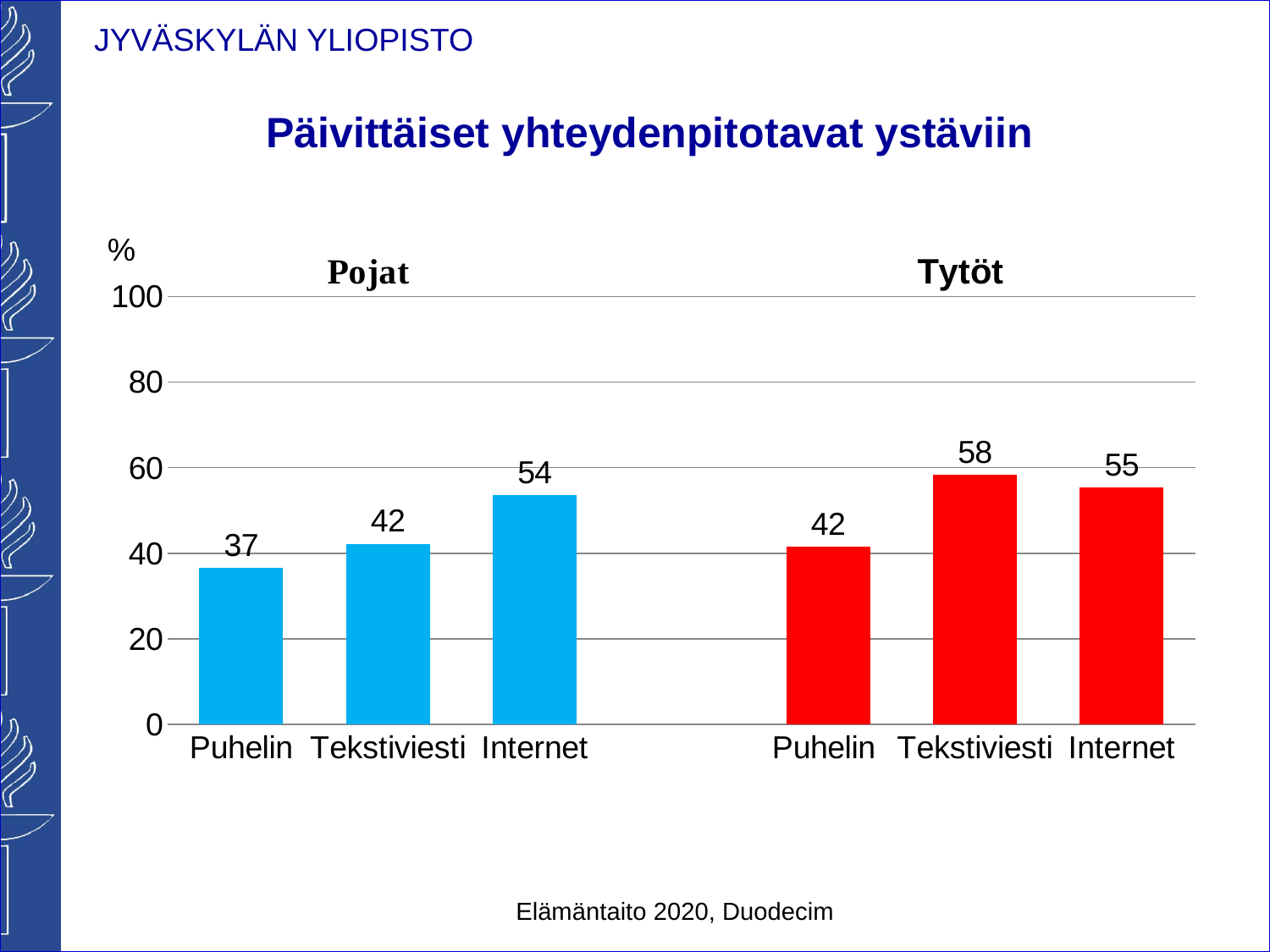
Which category has the highest value in the Tytöt group? Tekstiviesti How many bars are plotted in total on the chart? 6 Which category has the lowest value in the Pojat group? Puhelin What is the difference between the Internet values for Tytöt and Pojat? 1 What is the difference between Tekstiviesti and Puhelin in the Tytöt group? 16 What is the value for Tekstiviesti in the Tytöt group? 58 What kind of chart is shown on the slide? bar chart Is the value for Internet in the Pojat group greater or less than 60? less What colour are the bars for the Tytöt group? red What is the value for Puhelin in the Pojat group? 37 What is the value for Internet in the Pojat group? 54 Which is larger, Puhelin for Pojat or Puhelin for Tytöt? Puhelin for Tytöt